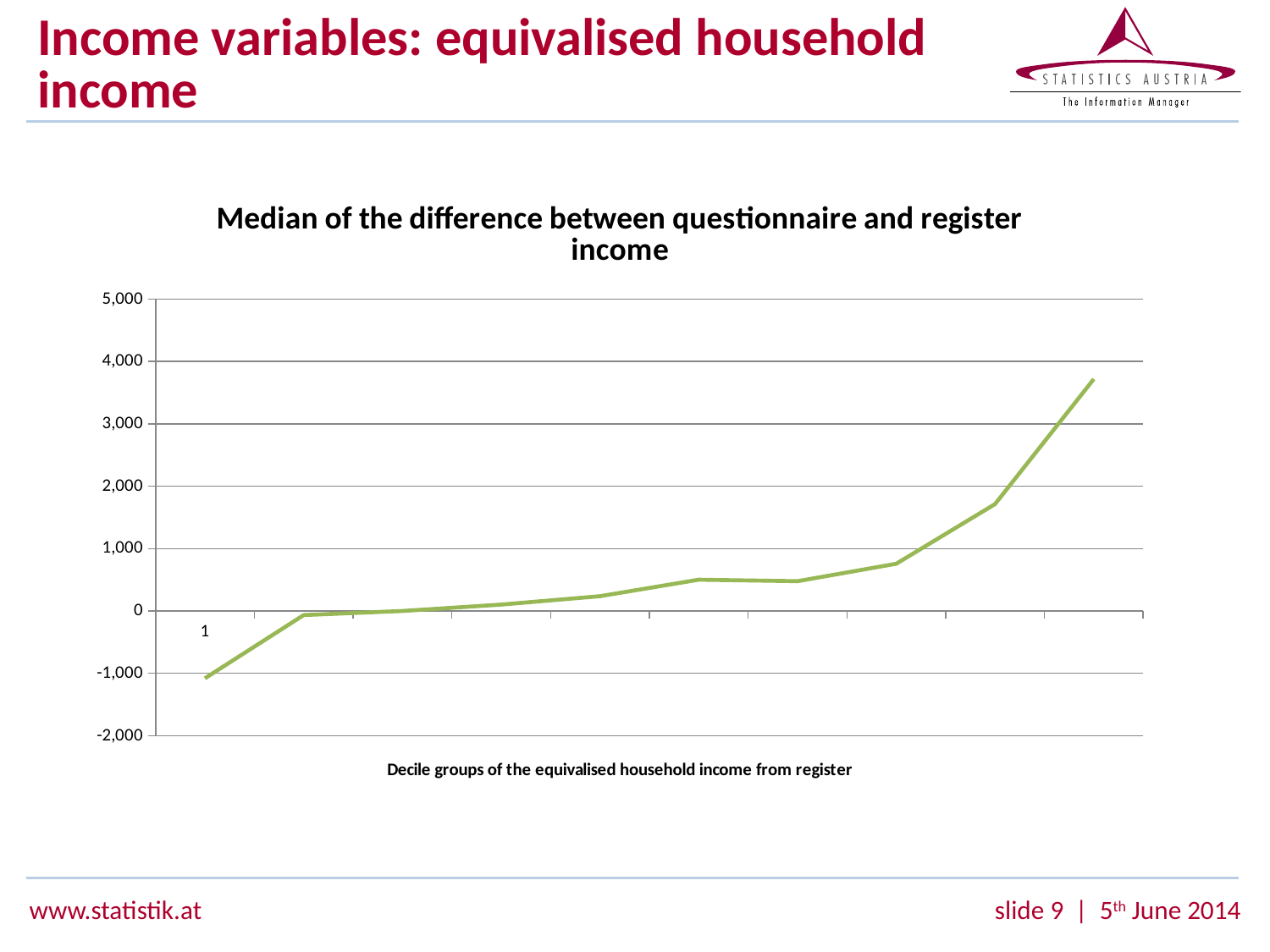
Which point on the line has the lowest value, the leftmost or the rightmost? the leftmost Which is larger, the value for decile group 1 or the value for the rightmost decile group? the rightmost decile group What is the x-axis title of the chart? Decile groups of the equivalised household income from register Which point on the line has the highest value, the leftmost or the rightmost? the rightmost What is the highest value shown on the y axis? 5,000 Do the values generally rise or fall from left to right along the x axis? rise What is the title of the chart? Median of the difference between questionnaire and register income Is the value for decile group 1 greater or less than 0? less Is the value for decile group 1 greater or less than 1,000? less Is the value for the rightmost point greater or less than 3,000? greater What kind of chart is shown on the slide? line chart